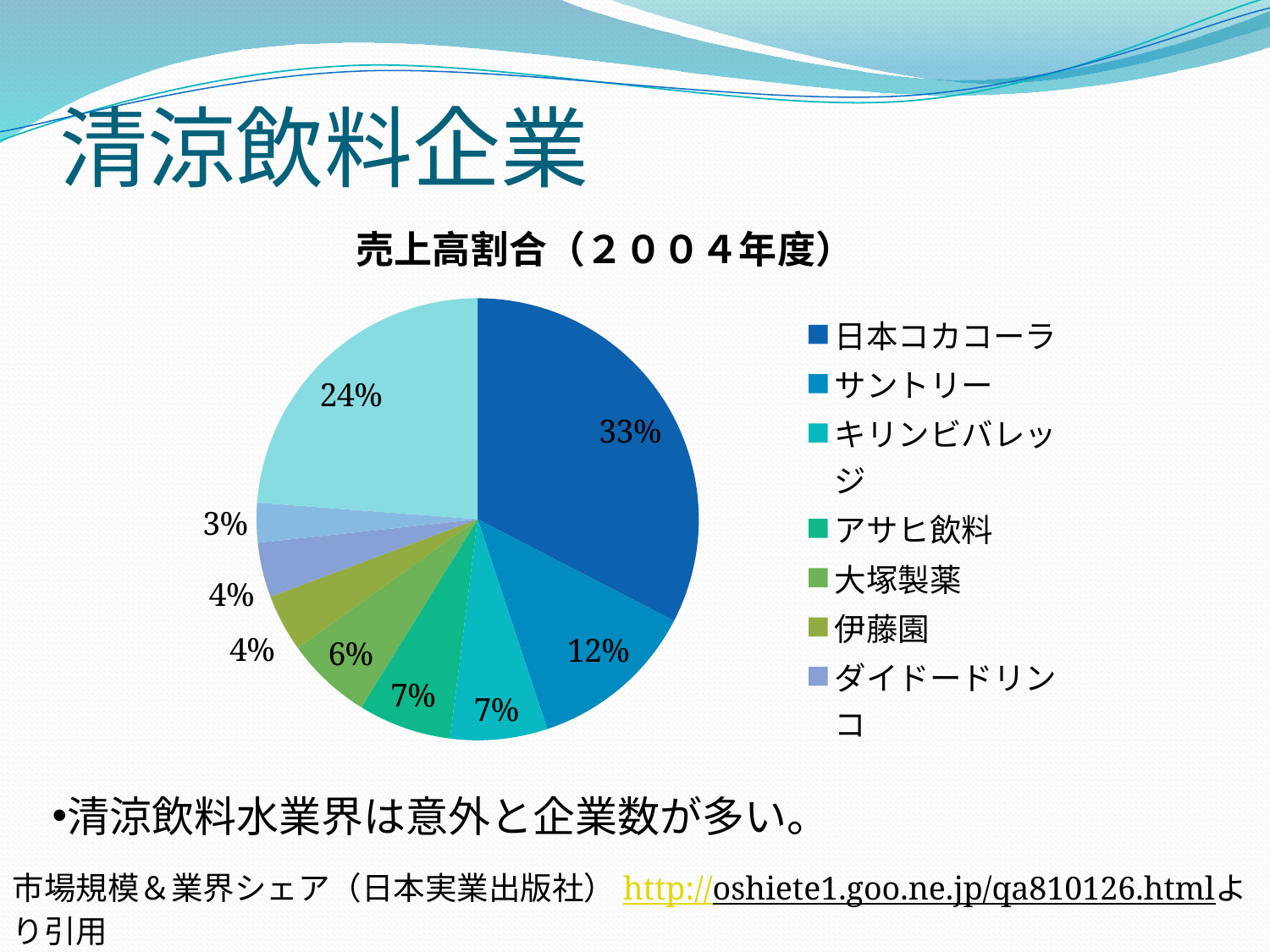
What share of the pie does 大塚製薬 hold? 6% What is the title of the chart? 売上高割合（２００４年度） What share of the pie does 日本コカコーラ hold? 33% How many slices does the pie chart have? 9 What share of the pie does キリンビバレッジ hold? 7% How many entries does the legend list? 7 What share of the pie does 伊藤園 hold? 4% Which is larger, the slice for サントリー or the slice for 大塚製薬? サントリー What kind of chart is shown on the slide? pie chart Which company has the largest slice of the pie? 日本コカコーラ What share of the pie does サントリー hold? 12% How many percentage points larger is the 日本コカコーラ slice than the サントリー slice? 21